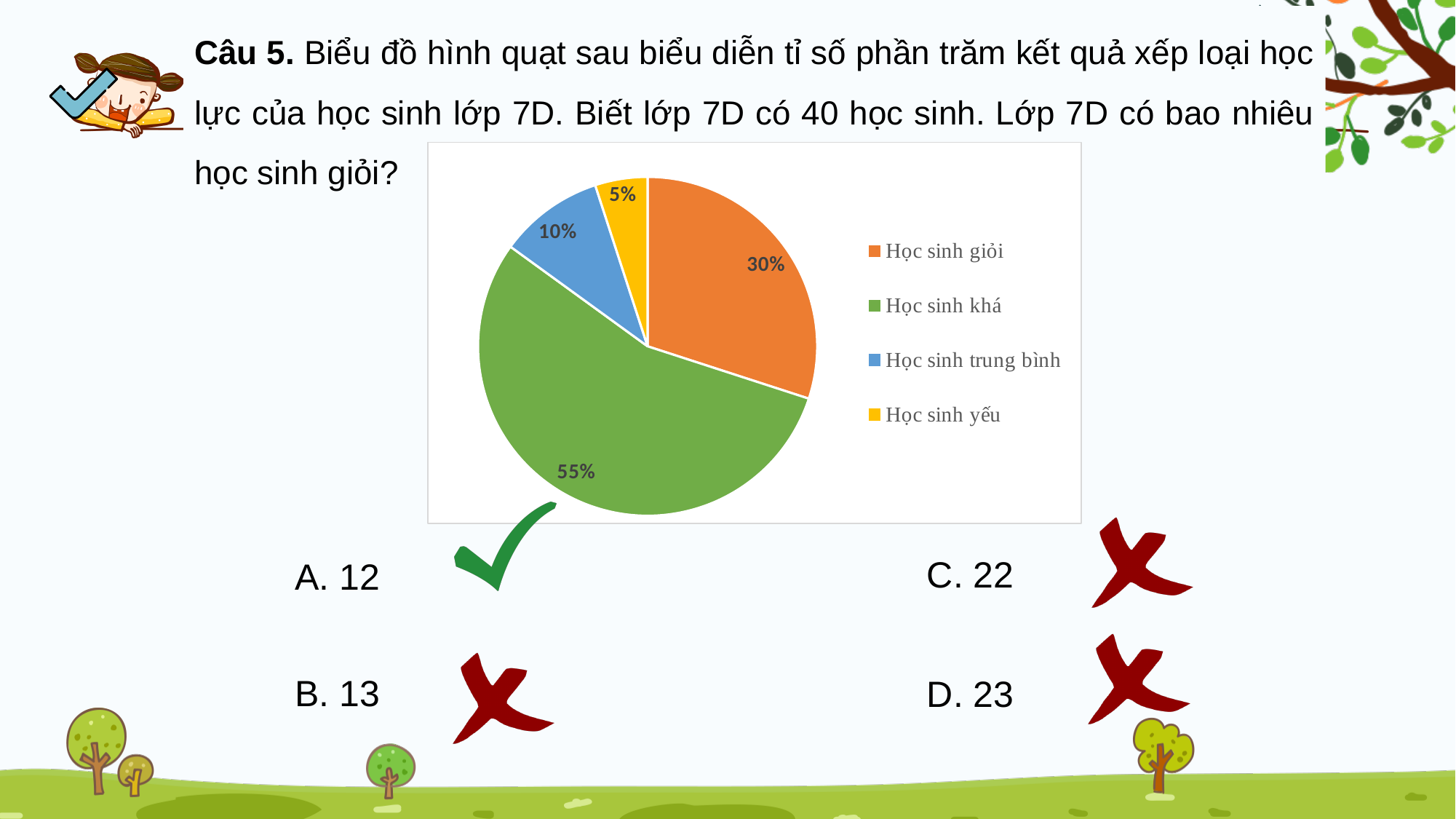
What percentage of the pie is labelled for Học sinh khá? 55% What percentage of the pie is labelled for Học sinh giỏi? 30% Which legend entry is shown in blue? Học sinh trung bình What colour is the slice for Học sinh giỏi? orange What percentage of the pie is labelled for Học sinh trung bình? 10% How many categories does the pie chart show? 4 What kind of chart is shown on the slide? pie chart What percentage of the pie is labelled for Học sinh yếu? 5% Which category has the largest slice of the pie? Học sinh khá What is the difference in percentage points between Học sinh khá and Học sinh giỏi? 25 Which slice is larger, Học sinh trung bình or Học sinh yếu? Học sinh trung bình Which category has the smallest slice of the pie? Học sinh yếu